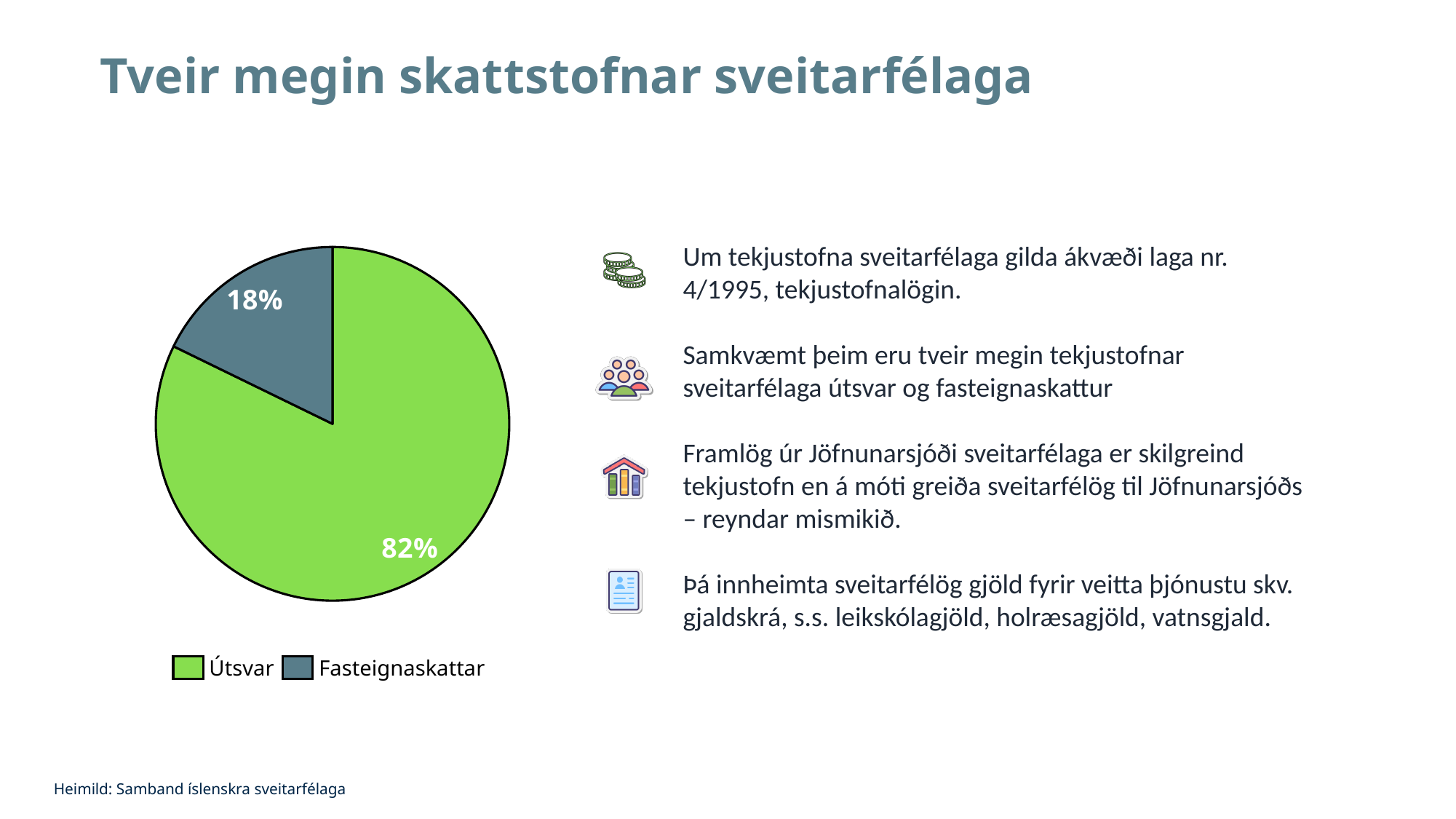
How many entries does the legend list? 2 What share of the pie does Fasteignaskattar represent? 18% Which category has the smallest slice of the pie? Fasteignaskattar What is the difference in percentage points between the Útsvar and Fasteignaskattar slices? 64 What type of chart is shown on the slide? Pie chart What share of the pie does Útsvar represent? 82% Which is larger, the Útsvar slice or the Fasteignaskattar slice? Útsvar Which category has the largest slice of the pie? Útsvar How many slices does the pie chart have? 2 What colour is the Útsvar slice? Green What colour is the Fasteignaskattar slice? Dark blue-grey What is the total of the two percentages shown on the pie chart? 100%